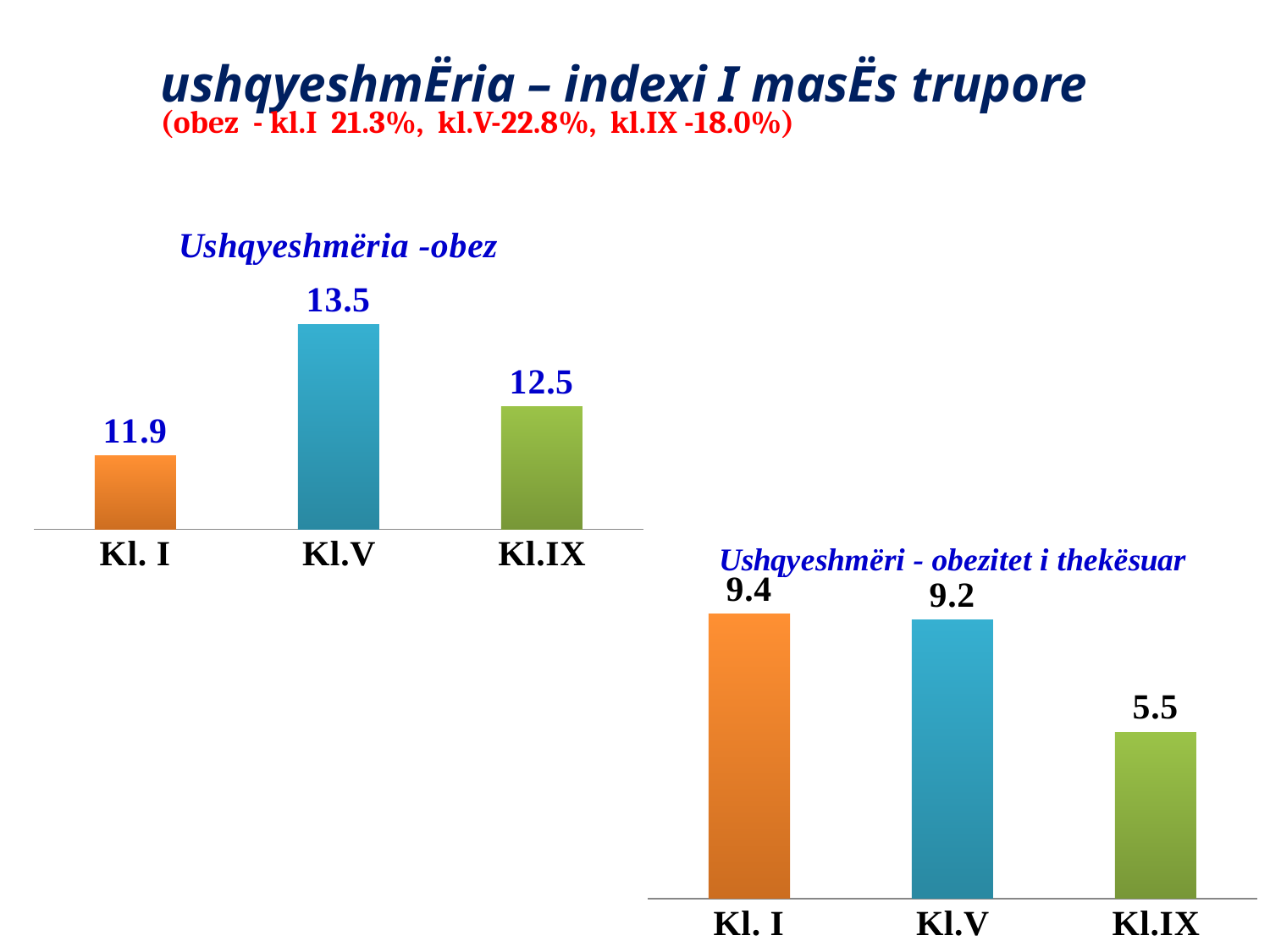
In the 'Ushqyeshmëria -obez' chart, which category has the lowest value? Kl. I What kind of chart is the 'Ushqyeshmëri - obezitet i thekësuar' chart? bar chart In the 'Ushqyeshmëria -obez' chart, which category has the highest value? Kl.V In the 'Ushqyeshmëria -obez' chart, what is the difference between the values for Kl.V and Kl.IX? 1.0 In the 'Ushqyeshmëri - obezitet i thekësuar' chart, what is the difference between the values for Kl. I and Kl.IX? 3.9 In the 'Ushqyeshmëri - obezitet i thekësuar' chart, do the values rise or fall from Kl. I to Kl.IX? fall In the 'Ushqyeshmëri - obezitet i thekësuar' chart, which category has the lowest value? Kl.IX In the 'Ushqyeshmëri - obezitet i thekësuar' chart, what is the value for Kl.IX? 5.5 In the 'Ushqyeshmëria -obez' chart, what is the value for Kl.V? 13.5 In the 'Ushqyeshmëria -obez' chart, what is the value for Kl. I? 11.9 In the 'Ushqyeshmëri - obezitet i thekësuar' chart, what is the value for Kl. I? 9.4 How many categories does the 'Ushqyeshmëria -obez' chart show? 3